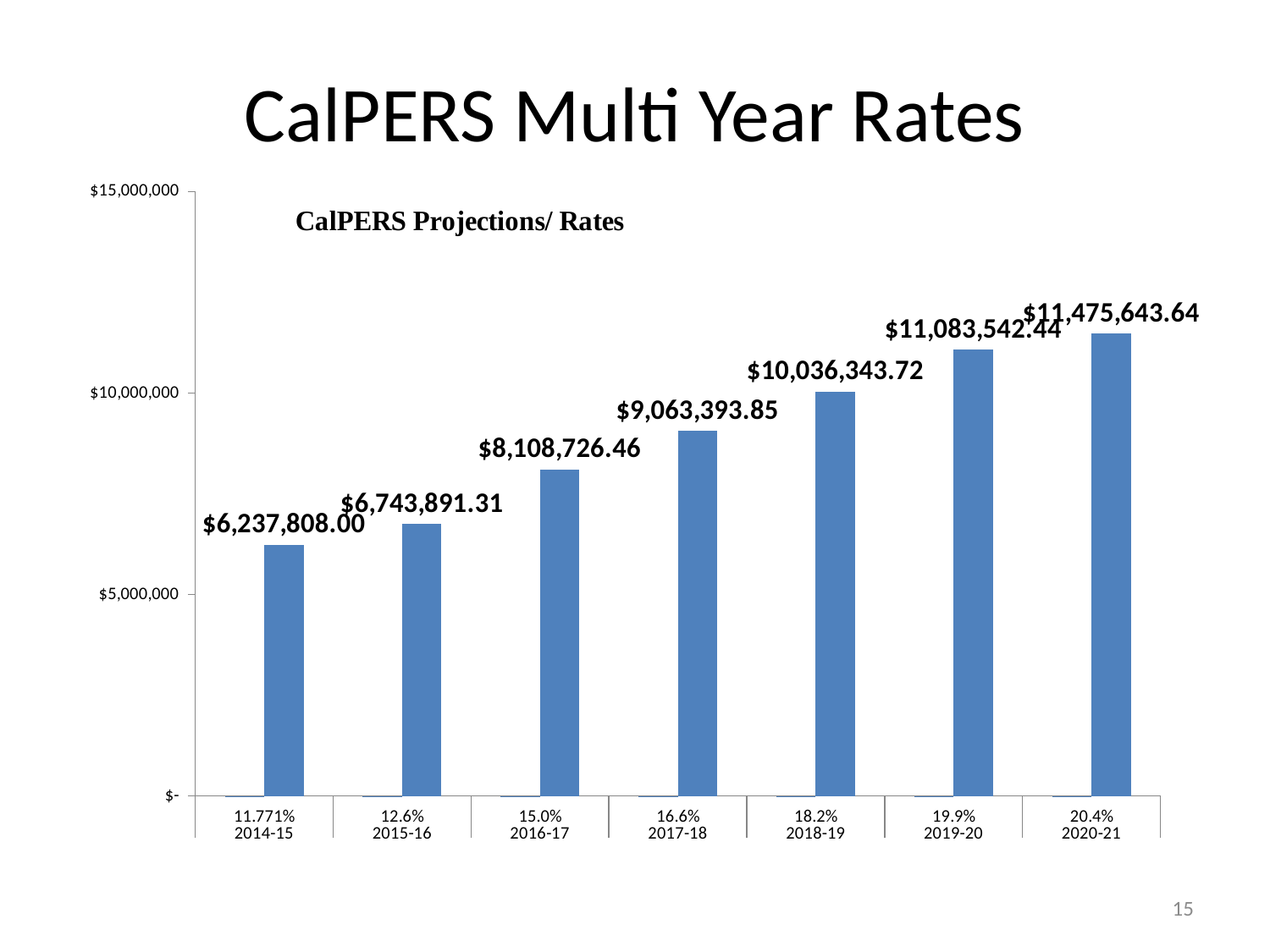
Do the values rise or fall from 2014-15 to 2020-21? Rise What is the value for 2020-21? $11,475,643.64 What is the difference between the values for 2015-16 and 2014-15? $506,083.31 What is the value for 2016-17? $8,108,726.46 What is the difference between the values for 2017-18 and 2016-17? $954,667.39 How many years are shown on the x axis? 7 Which year has the lowest value? 2014-15 What type of chart is shown on the slide? Bar chart Which year has the highest value? 2020-21 What is the value for 2018-19? $10,036,343.72 Which is larger, the value for 2017-18 or the value for 2018-19? 2018-19 What is the value for 2014-15? $6,237,808.00